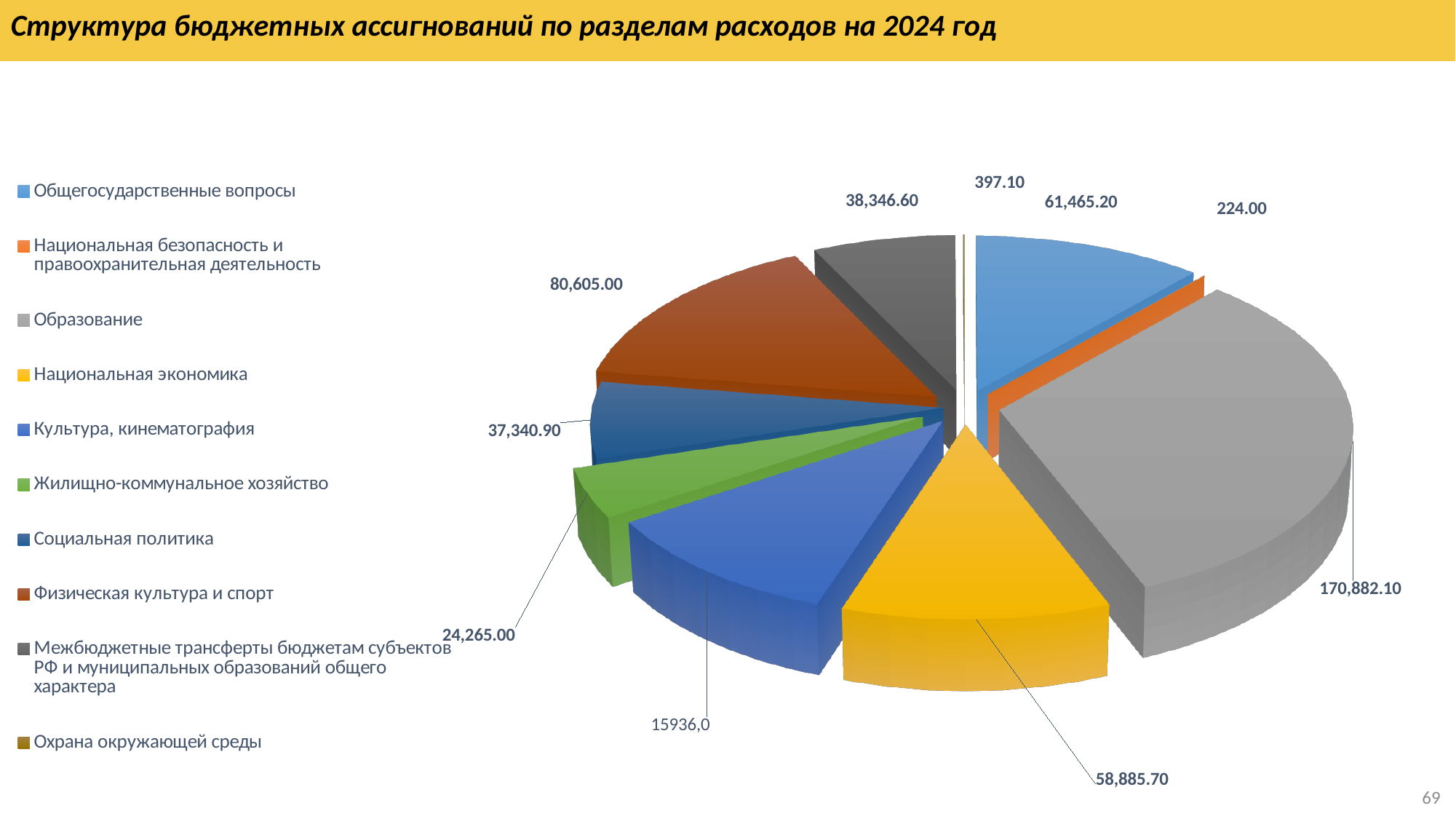
What is the title of the chart? Структура бюджетных ассигнований по разделам расходов на 2024 год What is the value for Физическая культура и спорт? 80,605.00 What is the difference between the values for Общегосударственные вопросы and Национальная экономика? 2,579.50 How many categories does the legend list? 10 What is the value for Образование? 170,882.10 What type of chart is shown on the slide? Pie chart What is the difference between the values for Образование and Физическая культура и спорт? 90,277.10 What is the value for Национальная безопасность и правоохранительная деятельность? 224.00 Which category has the smallest value? Национальная безопасность и правоохранительная деятельность Which is larger: Социальная политика or Межбюджетные трансферты бюджетам субъектов РФ и муниципальных образований общего характера? Межбюджетные трансферты бюджетам субъектов РФ и муниципальных образований общего характера What is the value for Культура, кинематография? 15936,0 Which category has the largest value? Образование